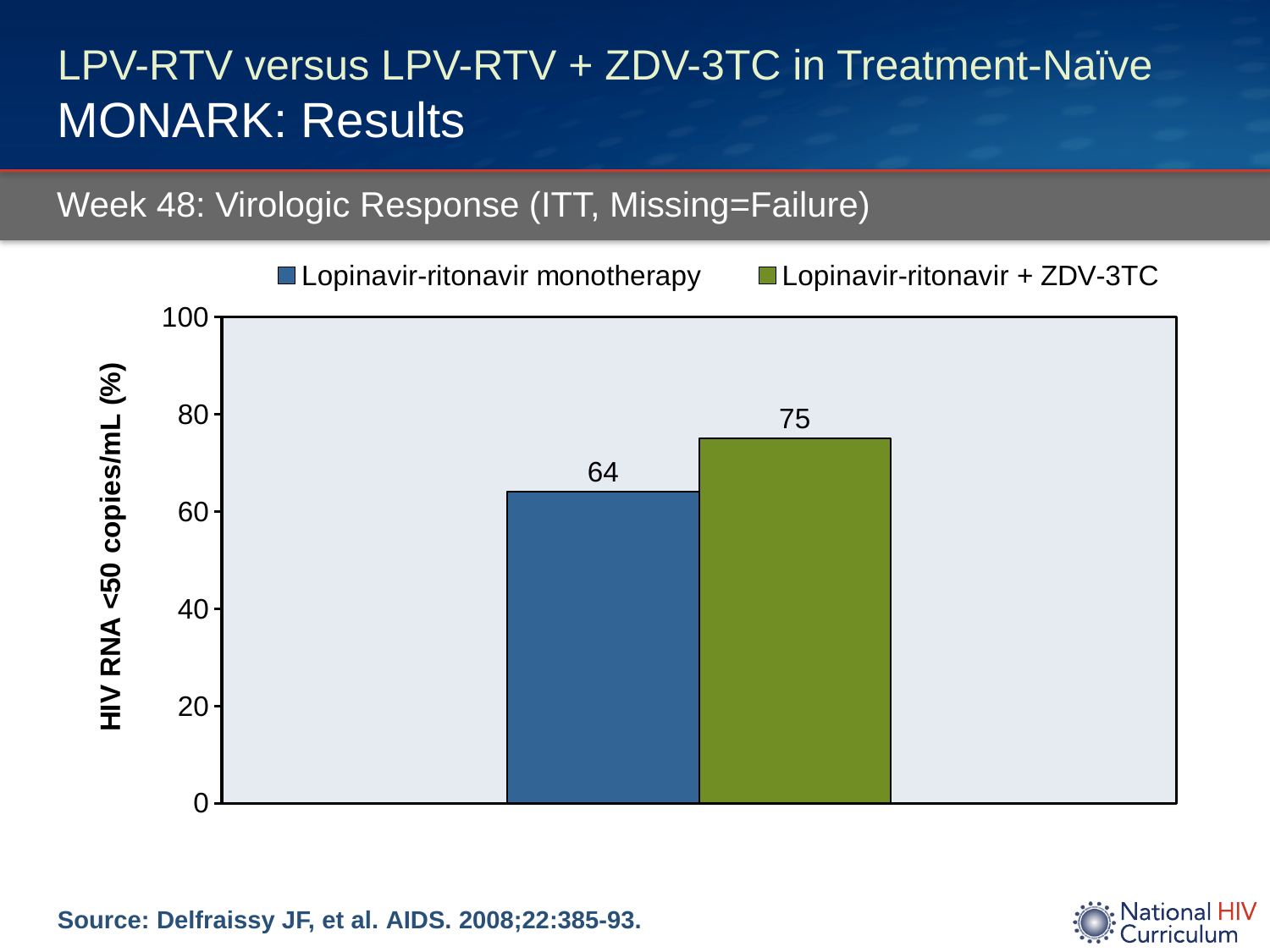
Which series has the lower value? Lopinavir-ritonavir monotherapy How many series does the legend list? 2 Is the value for Lopinavir-ritonavir + ZDV-3TC greater or less than 80? less What is the value for Lopinavir-ritonavir + ZDV-3TC? 75 What is the value for Lopinavir-ritonavir monotherapy? 64 Is the value for Lopinavir-ritonavir monotherapy greater or less than 60? greater What is the difference between the Lopinavir-ritonavir + ZDV-3TC value and the Lopinavir-ritonavir monotherapy value? 11 Is the value for Lopinavir-ritonavir monotherapy larger or smaller than the value for Lopinavir-ritonavir + ZDV-3TC? smaller How many bars are plotted on the chart? 2 Which series has the higher value? Lopinavir-ritonavir + ZDV-3TC What kind of chart is shown? bar chart What is the label of the y axis? HIV RNA <50 copies/mL (%)